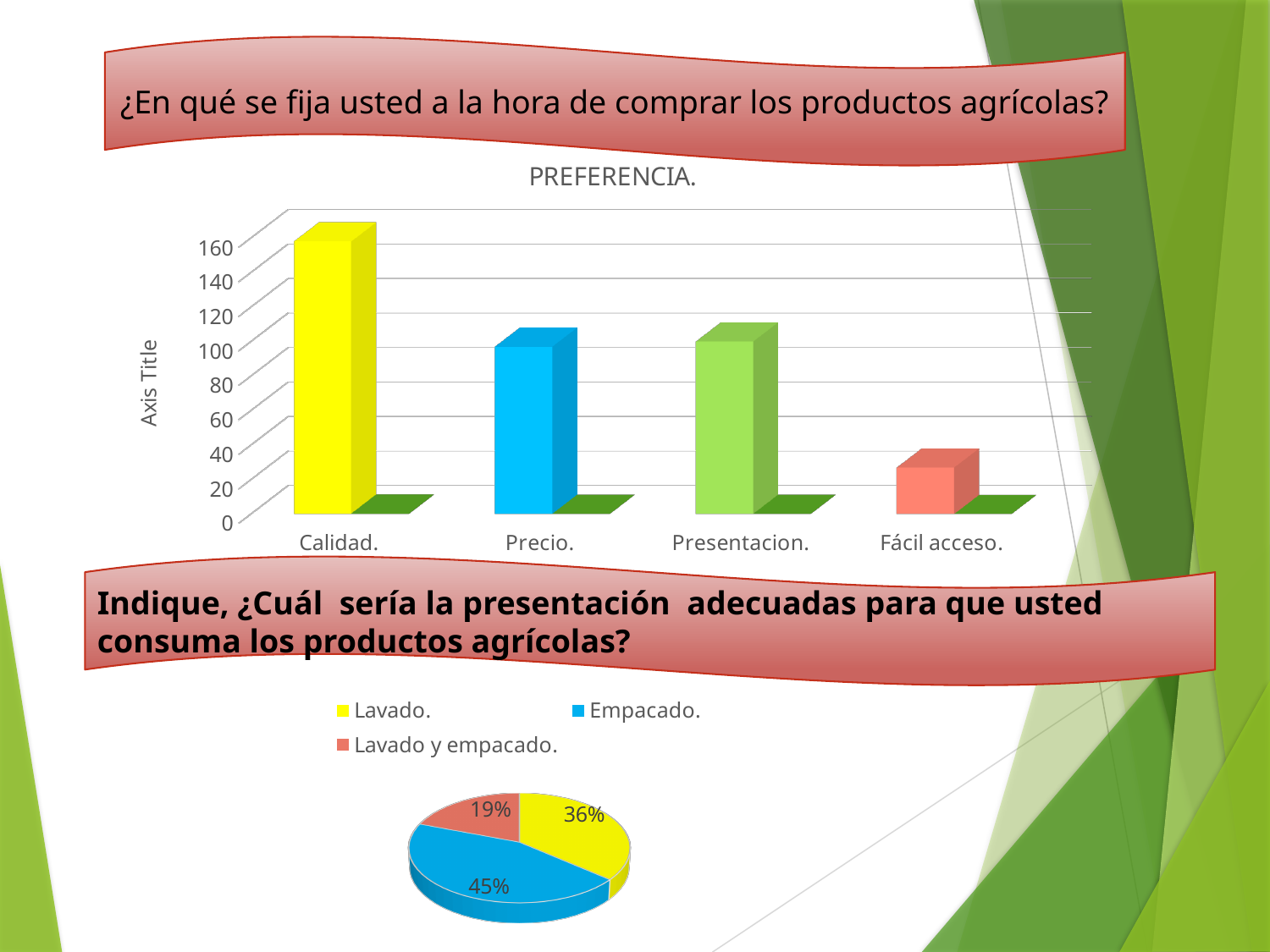
In the pie chart at the bottom of the slide, what percentage is shown for Empacado.? 45% In the PREFERENCIA. chart, is the value for Calidad. greater or less than 140? greater In the PREFERENCIA. chart, which is larger, the value for Calidad. or the value for Precio.? Calidad. In the PREFERENCIA. chart, is the value for Fácil acceso. greater or less than 60? less In the pie chart at the bottom of the slide, what is the difference between the Lavado. and Lavado y empacado. percentages? 17% What type of chart is the chart at the bottom of the slide? pie chart What type of chart is the chart titled PREFERENCIA.? bar chart In the PREFERENCIA. chart, which category has the lowest value? Fácil acceso. In the pie chart at the bottom of the slide, which slice is the largest? Empacado. In the PREFERENCIA. chart, how many categories are shown on the x axis? 4 In the pie chart at the bottom of the slide, what percentage is shown for Lavado y empacado.? 19% In the PREFERENCIA. chart, which category has the highest value? Calidad.